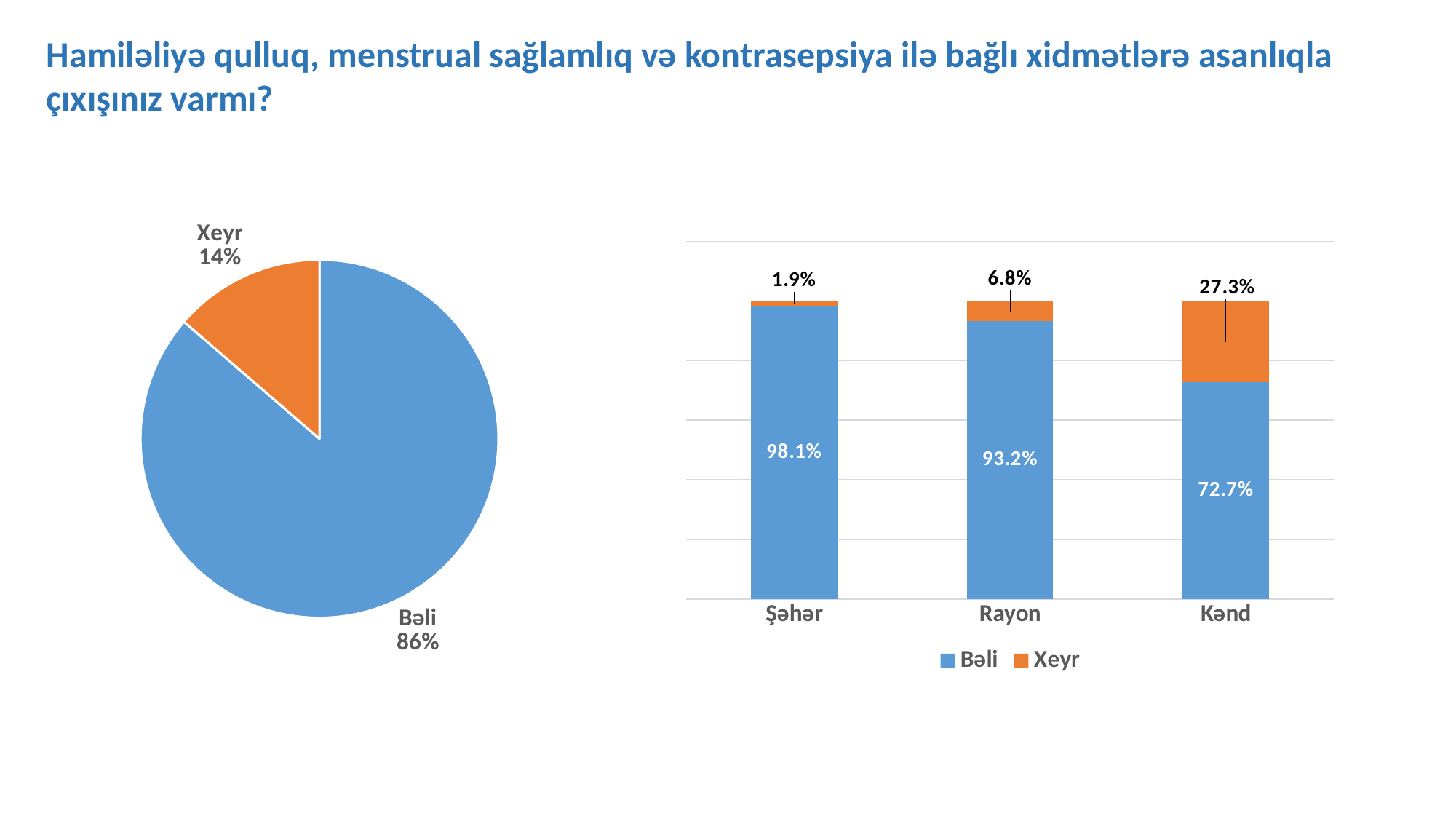
In the bar chart on the right, what is the difference between the Bəli values for Şəhər and Kənd? 25.4% In the pie chart on the left, what share is labelled for Xeyr? 14% How many series does the legend of the bar chart on the right list? 2 In the pie chart on the left, which slice is larger, Bəli or Xeyr? Bəli In the bar chart on the right, what is the Xeyr value for Kənd? 27.3% In the pie chart on the left, what share is labelled for Bəli? 86% What kind of chart is on the right of the slide? bar chart What kind of chart is on the left of the slide? pie chart In the bar chart on the right, what is the Xeyr value for Rayon? 6.8% In the bar chart on the right, which category has the lowest Bəli value? Kənd In the bar chart on the right, which category has the highest Xeyr value? Kənd In the bar chart on the right, what is the Bəli value for Şəhər? 98.1%